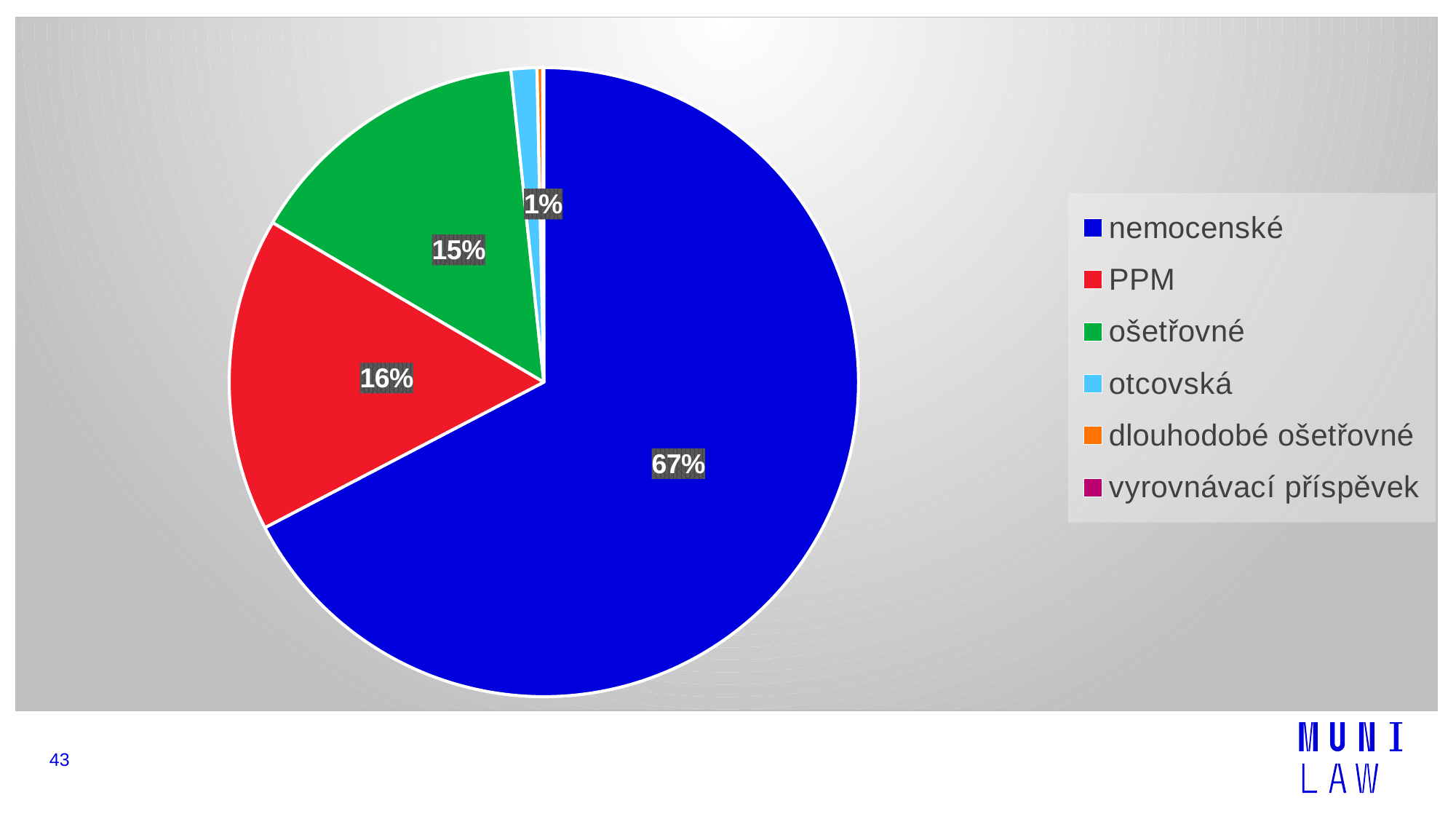
Which category has the largest slice of the pie? nemocenské What kind of chart is shown on the slide? pie chart Which legend entry is shown in orange? dlouhodobé ošetřovné What share of the pie does ošetřovné have? 15% Which is larger, the slice for PPM or the slice for ošetřovné? PPM How many categories does the legend list? 6 What colour is the slice for nemocenské? blue What is the difference in percentage points between the nemocenské slice and the PPM slice? 51 What is the difference in percentage points between the ošetřovné slice and the otcovská slice? 14 What share of the pie does otcovská have? 1% What share of the pie does PPM have? 16%